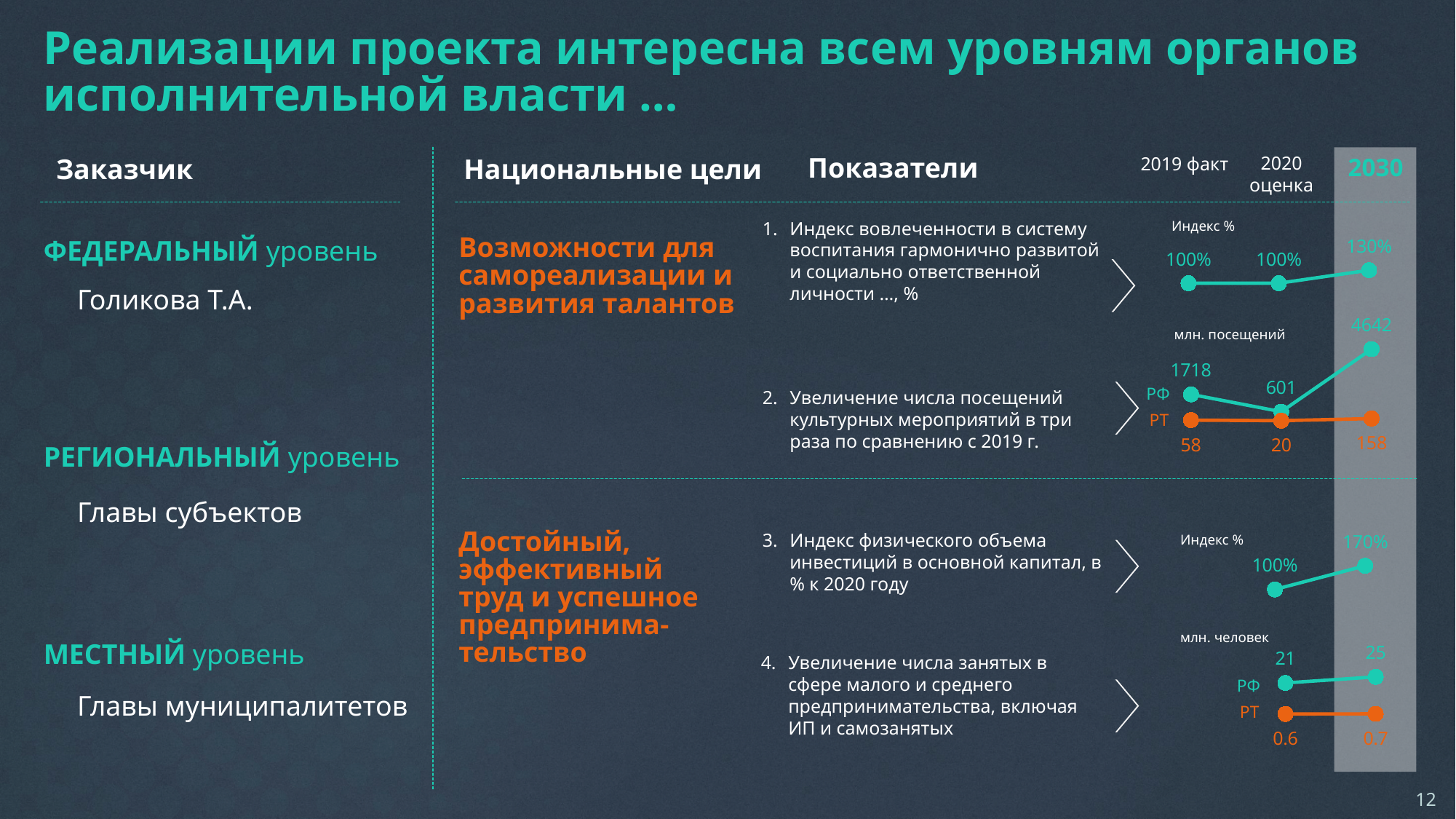
In the chart for indicator 1 (Индекс вовлеченности, Индекс %), what is the value for 2019 факт? 100% What type of chart is used for indicator 4 (млн. человек)? Line chart In the chart for indicator 4 (млн. человек), what is the РТ value for 2030? 0.7 In the chart for indicator 2 (млн. посещений), what is the РФ value for 2030? 4642 In the chart for indicator 3 (Индекс физического объема инвестиций, Индекс %), what is the value for 2030? 170% In the chart for indicator 1 (Индекс вовлеченности, Индекс %), what is the value for 2030? 130% In the chart for indicator 3 (Индекс физического объема инвестиций, Индекс %), how many data points are plotted? 2 In the chart for indicator 2 (млн. посещений), how many series are plotted? 2 In the chart for indicator 2 (млн. посещений), which year has the lowest РФ value? 2020 оценка In the chart for indicator 2 (млн. посещений), what is the РТ value for 2020 оценка? 20 In the chart for indicator 4 (млн. человек), what is the difference between the РФ values for 2030 and 2020? 4 In the chart for indicator 2 (млн. посещений), what is the difference between the РФ values for 2019 факт and 2020 оценка? 1117